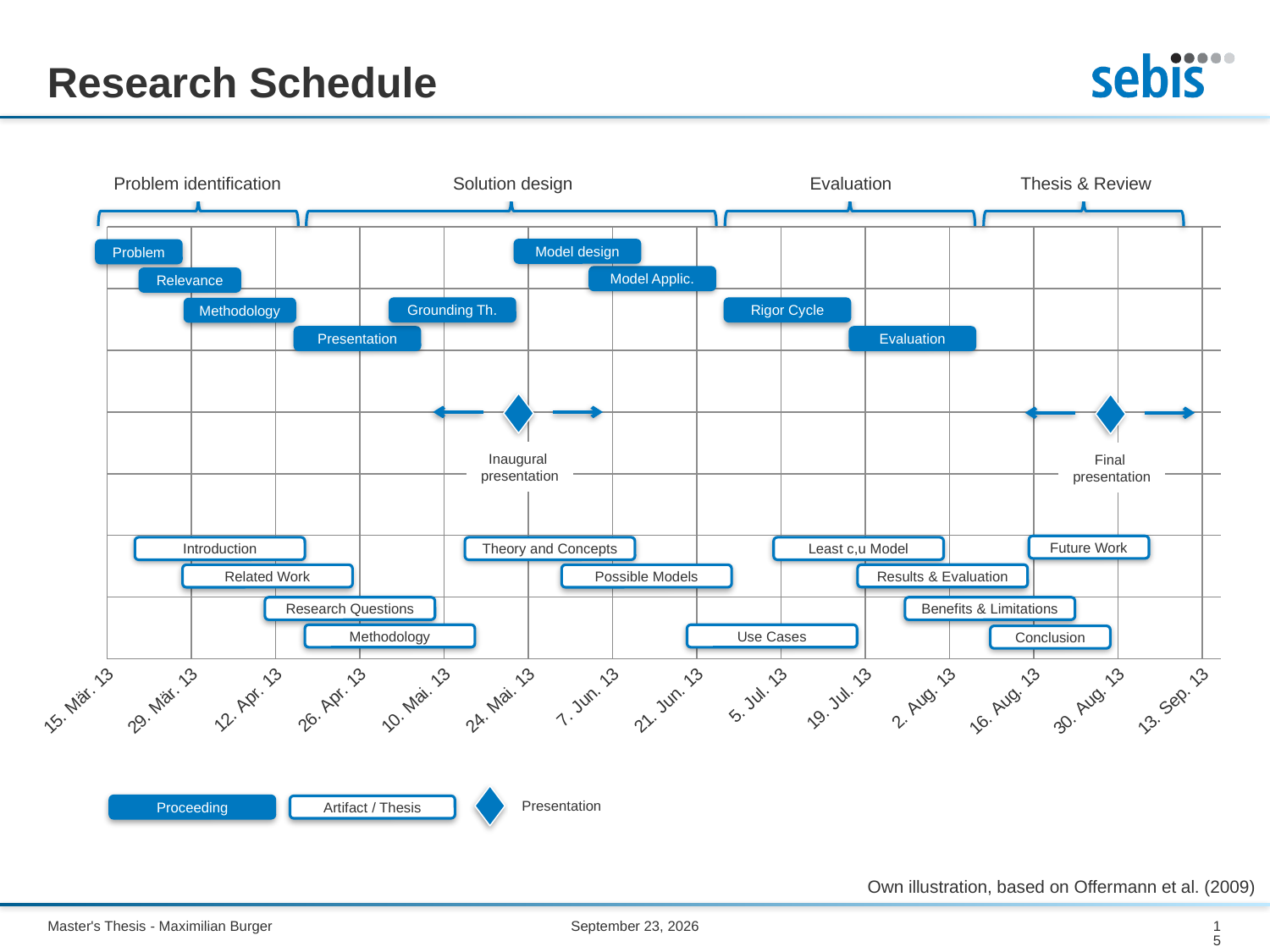
Which of the two presentation milestones comes first in time? Inaugural presentation What kind of chart is shown on the slide? Gantt chart Which legend entry is shown as a filled blue bar? Proceeding According to the note on the slide, whose work is the illustration based on? Offermann et al. (2009) How many entries does the legend list? 3 Which 'Proceeding' task is the last one on the timeline? Evaluation Which phase does the task 'Rigor Cycle' fall under? Evaluation What is the first date shown on the x axis? 15. Mär. 13 How many phases are labelled above the chart? 4 Which task starts earliest on the timeline? Problem What is the last date shown on the x axis? 13. Sep. 13 Which phase does the task 'Grounding Th.' fall under? Solution design